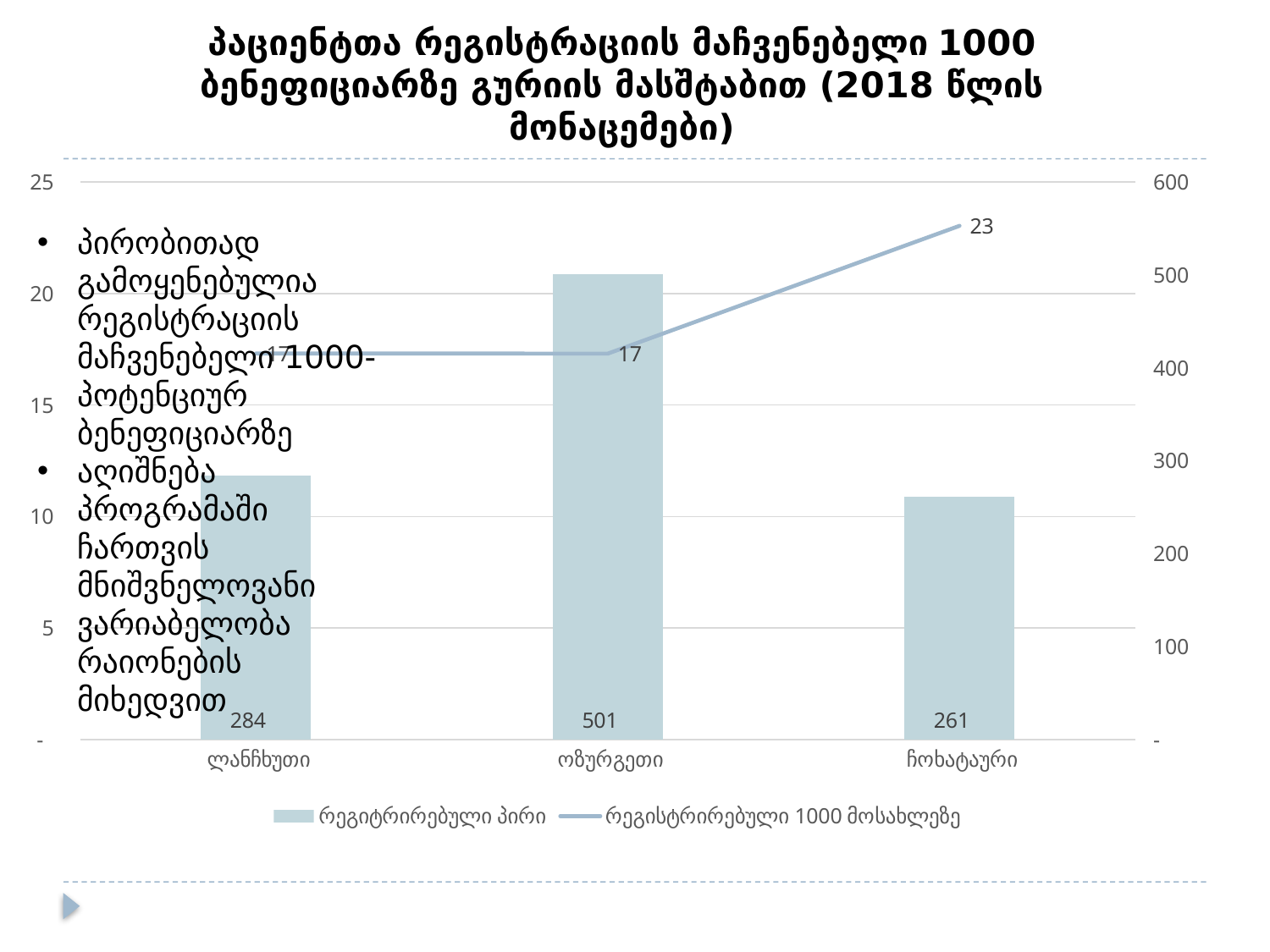
What is the value of რეგიტრირებული პირი for ლანჩხუთი? 284 How many categories are shown on the x axis? 3 What is the value of რეგისტრირებული 1000 მოსახლეზე for ჩოხატაური? 23 What is the difference between the რეგიტრირებული პირი values for ოზურგეთი and ჩოხატაური? 240 How many series does the legend list? 2 Which category has the highest value of რეგიტრირებული პირი? ოზურგეთი What is the value of რეგიტრირებული პირი for ჩოხატაური? 261 Which is larger, the რეგისტრირებული 1000 მოსახლეზე value for ჩოხატაური or for ოზურგეთი? ჩოხატაური What is the value of რეგისტრირებული 1000 მოსახლეზე for ოზურგეთი? 17 What is the value of რეგიტრირებული პირი for ოზურგეთი? 501 What kind of chart is this? Combined bar and line chart Which category has the lowest value of რეგიტრირებული პირი? ჩოხატაური